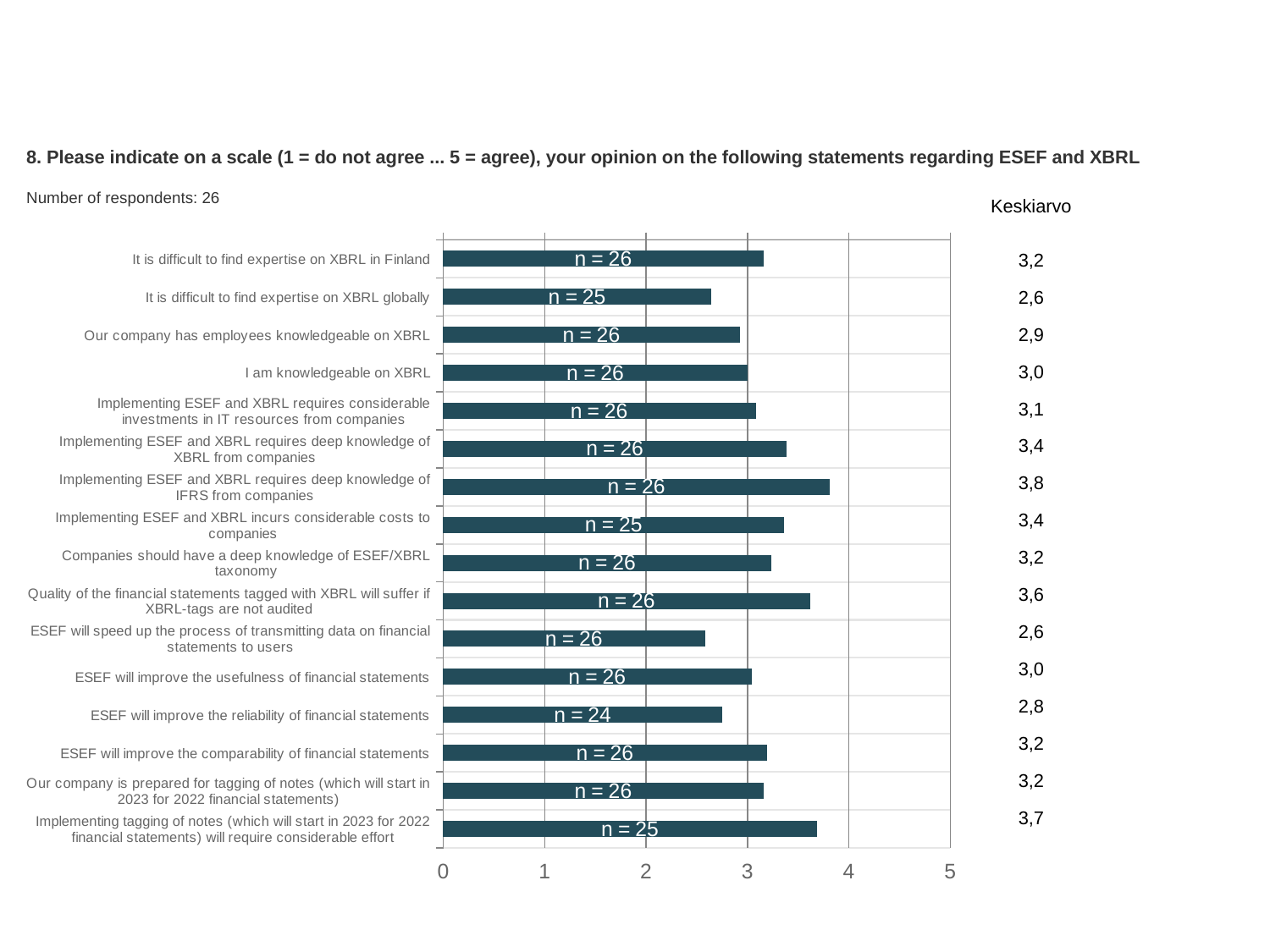
What is the mean (Keskiarvo) value for 'Implementing ESEF and XBRL requires deep knowledge of IFRS from companies'? 3,8 What is the mean (Keskiarvo) value for 'Quality of the financial statements tagged with XBRL will suffer if XBRL-tags are not audited'? 3,6 Is the bar for 'ESEF will improve the reliability of financial statements' greater or less than 3? less What kind of chart is shown on the slide? bar chart How many statements (categories) are plotted in the chart? 16 What is the mean (Keskiarvo) value for 'ESEF will improve the reliability of financial statements'? 2,8 How many respondents (n) are shown on the bar for 'ESEF will improve the reliability of financial statements'? n = 24 What is the difference between the mean value for 'Implementing ESEF and XBRL requires deep knowledge of IFRS from companies' and 'It is difficult to find expertise on XBRL globally'? 1,2 Which has a higher mean value: 'Implementing ESEF and XBRL requires deep knowledge of IFRS from companies' or 'Implementing ESEF and XBRL requires deep knowledge of XBRL from companies'? Implementing ESEF and XBRL requires deep knowledge of IFRS from companies Which statement has the highest mean value? Implementing ESEF and XBRL requires deep knowledge of IFRS from companies What is the label of the column of mean values printed to the right of the chart? Keskiarvo How many respondents (n) are shown on the bar for 'Implementing tagging of notes (which will start in 2023 for 2022 financial statements) will require considerable effort'? n = 25